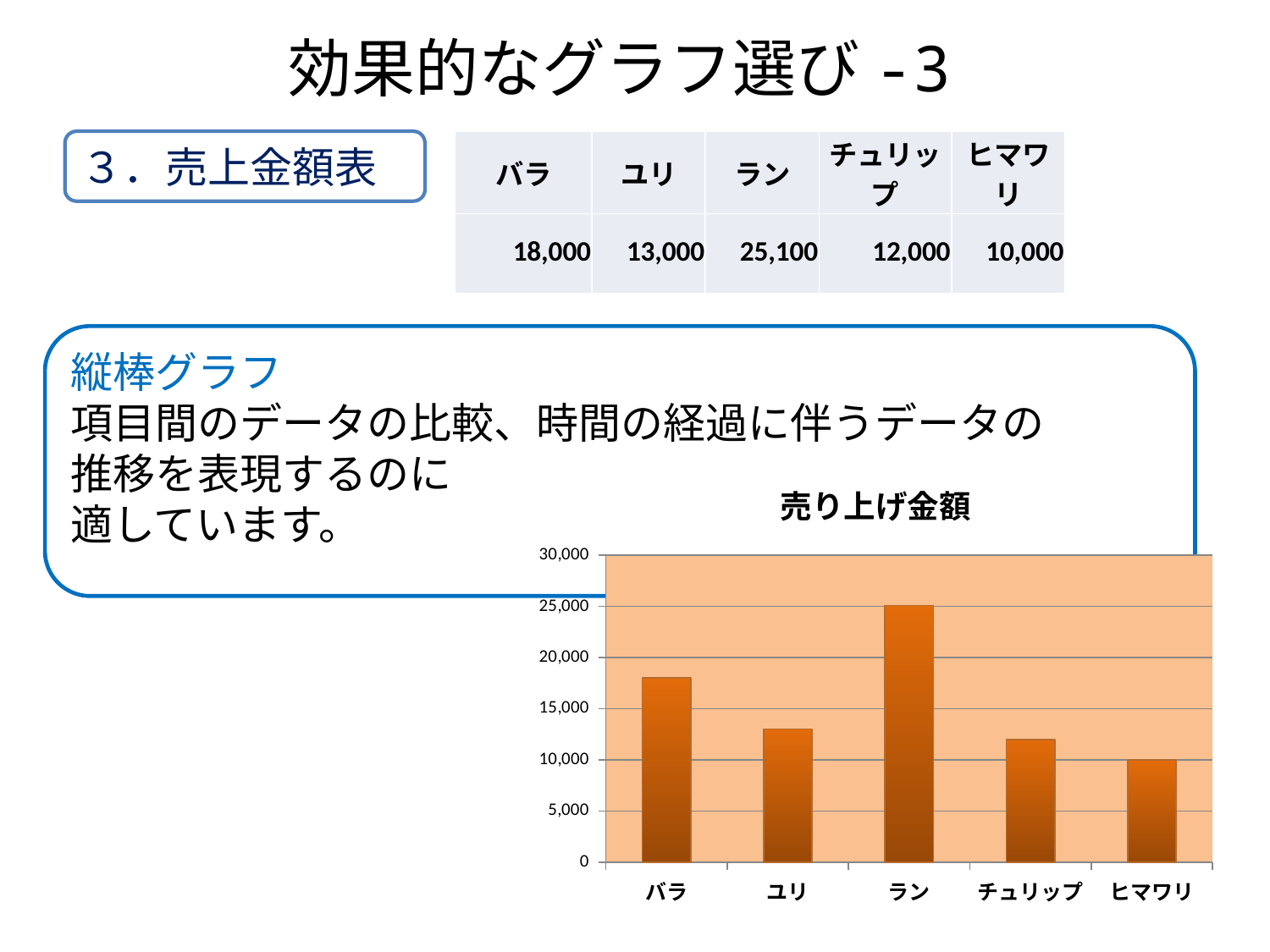
What is the value for バラ? 18,000 Which category has the lowest value in the chart? ヒマワリ What is the title of the chart? 売り上げ金額 What is the value for ヒマワリ? 10,000 What is the value for ラン? 25,100 Which is larger, the value for ユリ or the value for チュリップ? ユリ Is the value for バラ greater or less than 15,000? greater Which category has the highest value in the chart? ラン Is the value for チュリップ greater or less than 15,000? less What is the difference between the values for ラン and バラ? 7,100 How many categories are plotted in the chart? 5 What type of chart is shown on the slide? bar chart